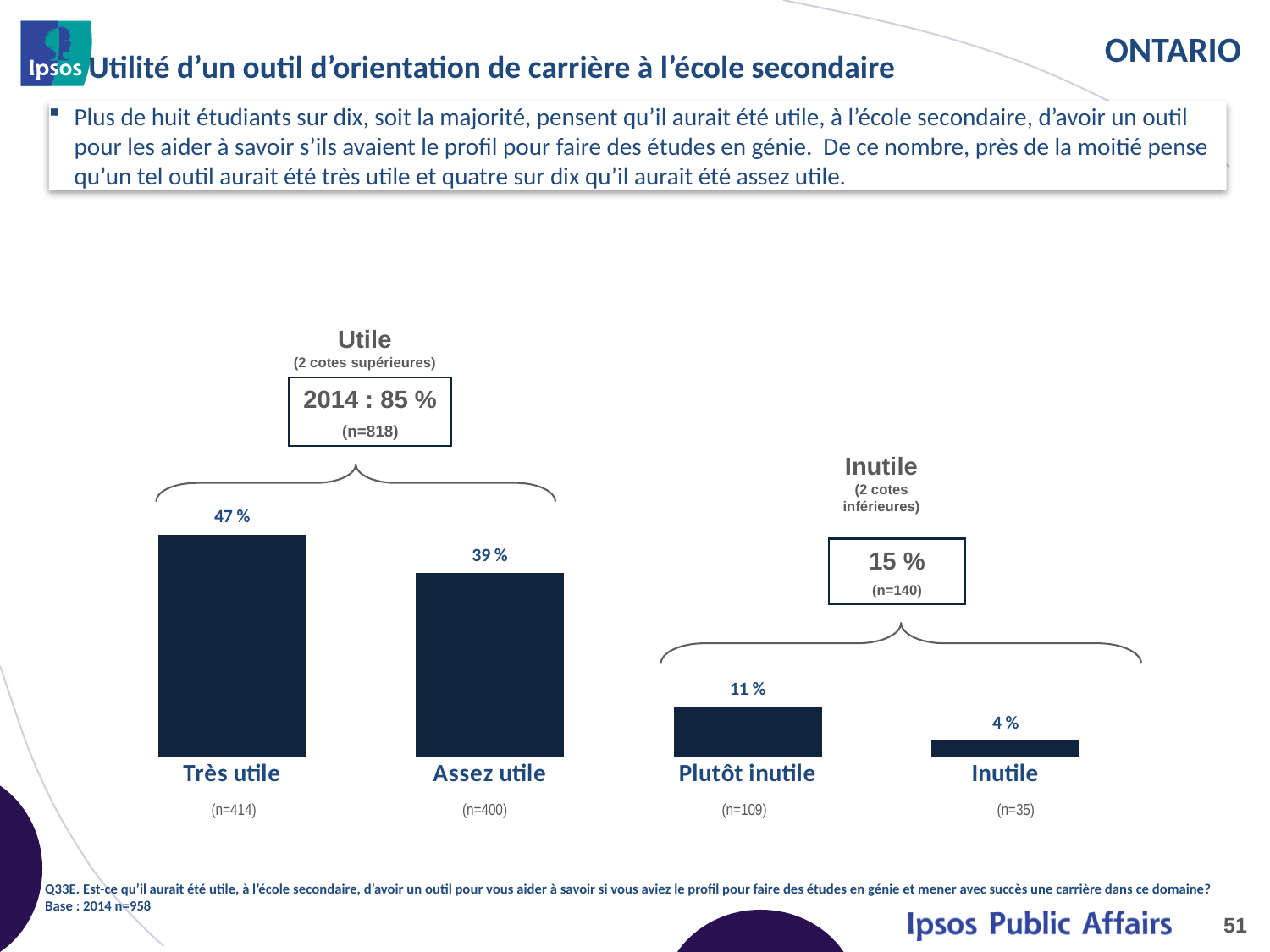
What kind of chart is shown on the slide? Bar chart Which category has the lowest value in the chart? Inutile What combined percentage is shown in the "Utile (2 cotes supérieures)" box for 2014? 85 % What is the difference between the "Très utile" and "Assez utile" values? 8 % What is the value shown for the "Assez utile" bar? 39 % Which category has the highest value in the chart? Très utile What percentage of students said a career orientation tool would have been "Très utile"? 47 % What is the value of the "Inutile" bar? 4 % How many categories are plotted in the chart? 4 Which is larger, the value for "Plutôt inutile" or the value for "Inutile"? Plutôt inutile What is the sample size (n) shown under the "Très utile" bar? n=414 What percentage is shown for "Plutôt inutile"? 11 %